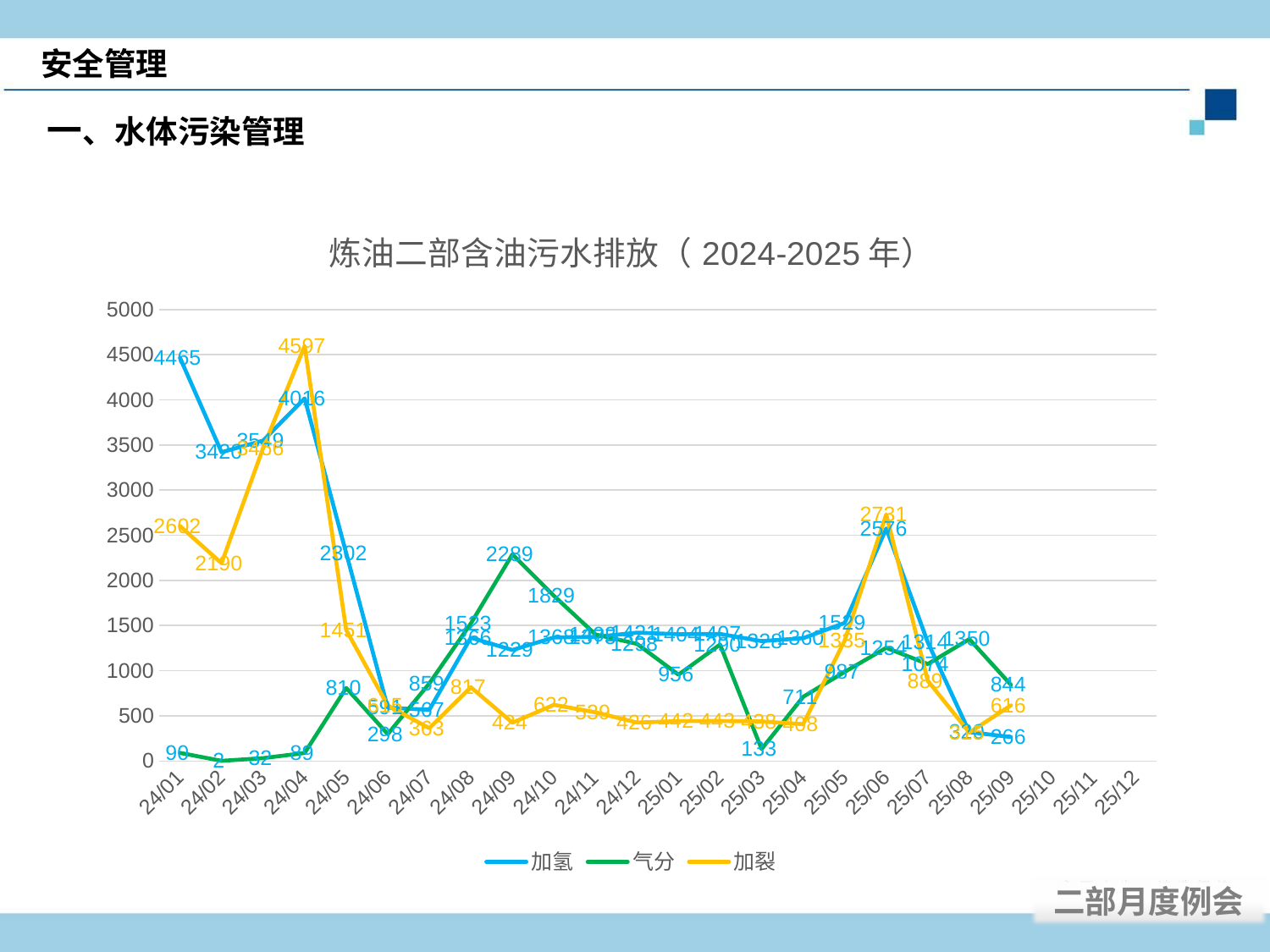
What kind of chart is shown on the slide? line chart In which month does 加裂 reach its highest value? 24/04 Is the value of 气分 at 24/10 greater or less than 1500? greater In which month does 气分 reach its highest value? 24/09 Which is larger at 24/05: 加氢 or 加裂? 加氢 What is the value of 气分 at 24/09? 2289 What is the value of 加裂 at 24/04? 4597 How many series does the legend list? 3 What is the value of 加氢 at 24/01? 4465 What is the value of 加裂 at 25/06? 2731 What is the difference between 加裂 and 加氢 at 25/06? 155